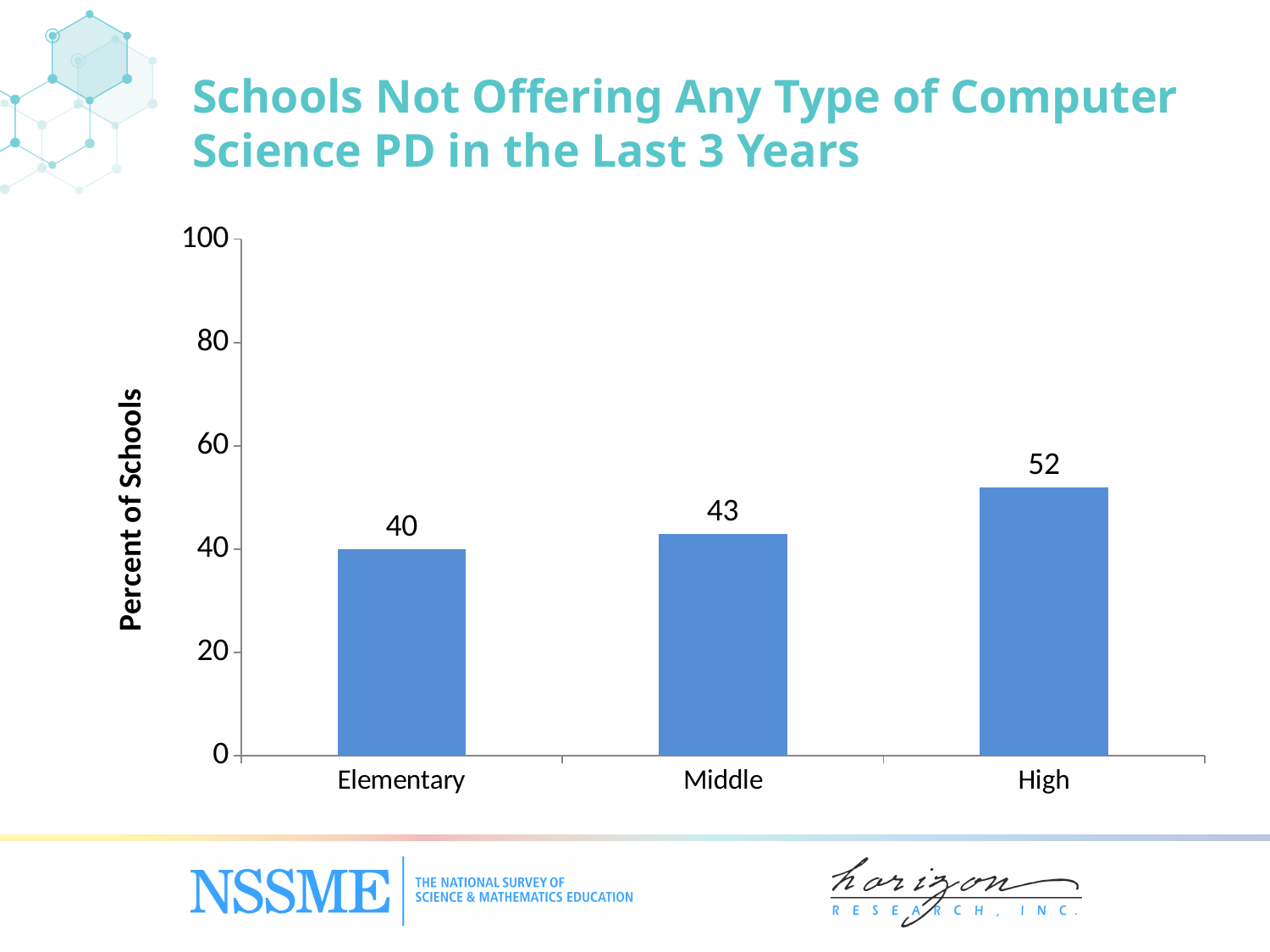
What kind of chart is shown on the slide? bar chart Is the value for High greater or less than 60? less What is the value for Elementary schools? 40 Which school level has the highest percent of schools not offering computer science PD? High What is the value for High schools? 52 Which is larger, the value for High or the value for Middle? High What is the value for Middle schools? 43 Do the values rise or fall from Elementary to High? rise How many school levels are shown on the chart? 3 What is the difference between the values for Middle and Elementary? 3 What is the difference between the values for High and Elementary? 12 Which school level has the lowest percent of schools not offering computer science PD? Elementary